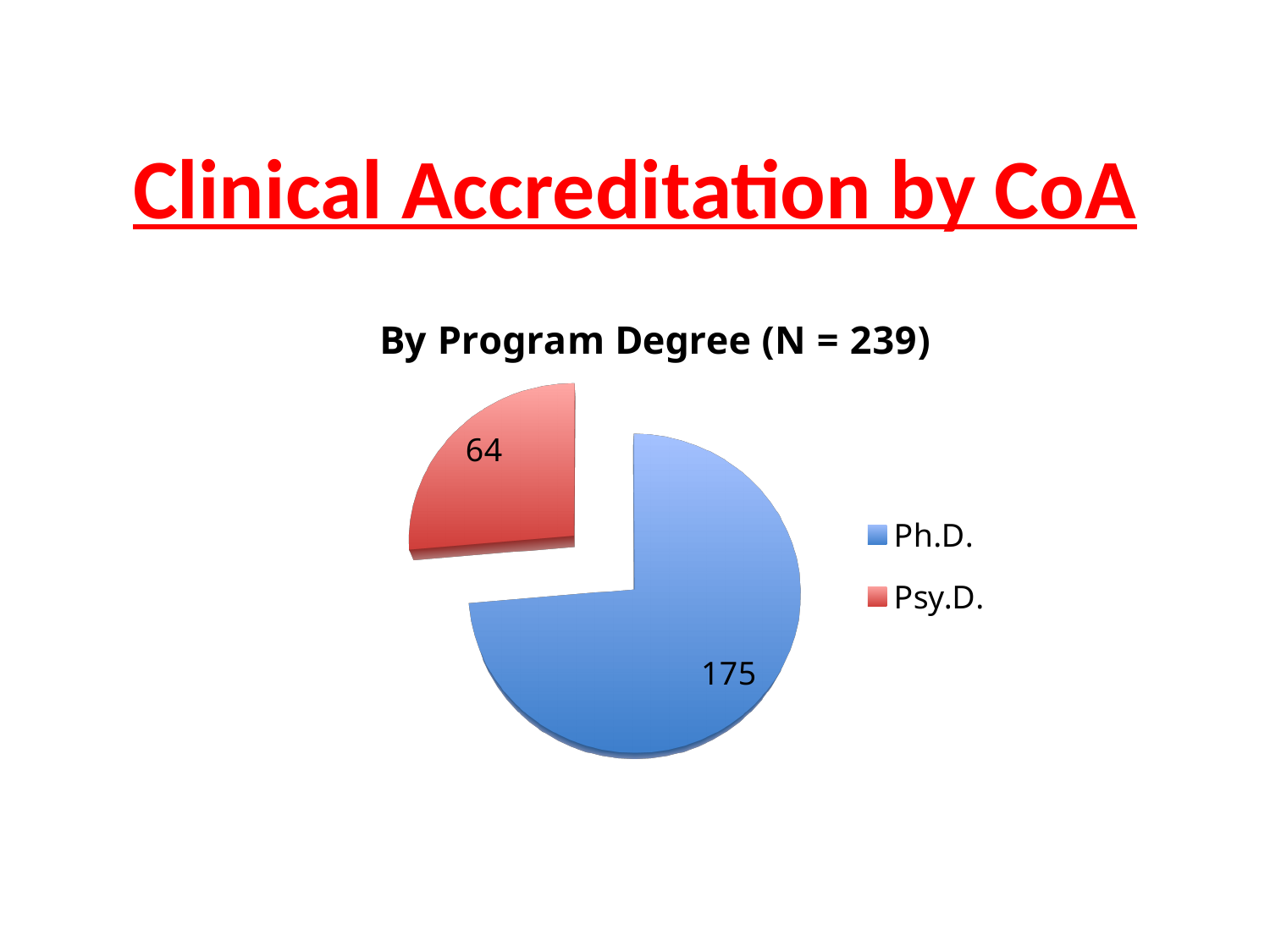
How many slices does the pie chart have? 2 What is the value for Ph.D. in the pie chart? 175 Which is larger, the Ph.D. value or the Psy.D. value? Ph.D. What is the title of the chart? By Program Degree (N = 239) Which program degree has the smallest slice of the pie? Psy.D. What kind of chart is shown on the slide? Pie chart How many entries does the legend list? 2 What is the difference between the Ph.D. and Psy.D. values? 111 What is the total of the two slices in the pie chart? 239 What colour is the Psy.D. slice in the pie chart? Red Which program degree has the largest slice of the pie? Ph.D. What is the value for Psy.D. in the pie chart? 64